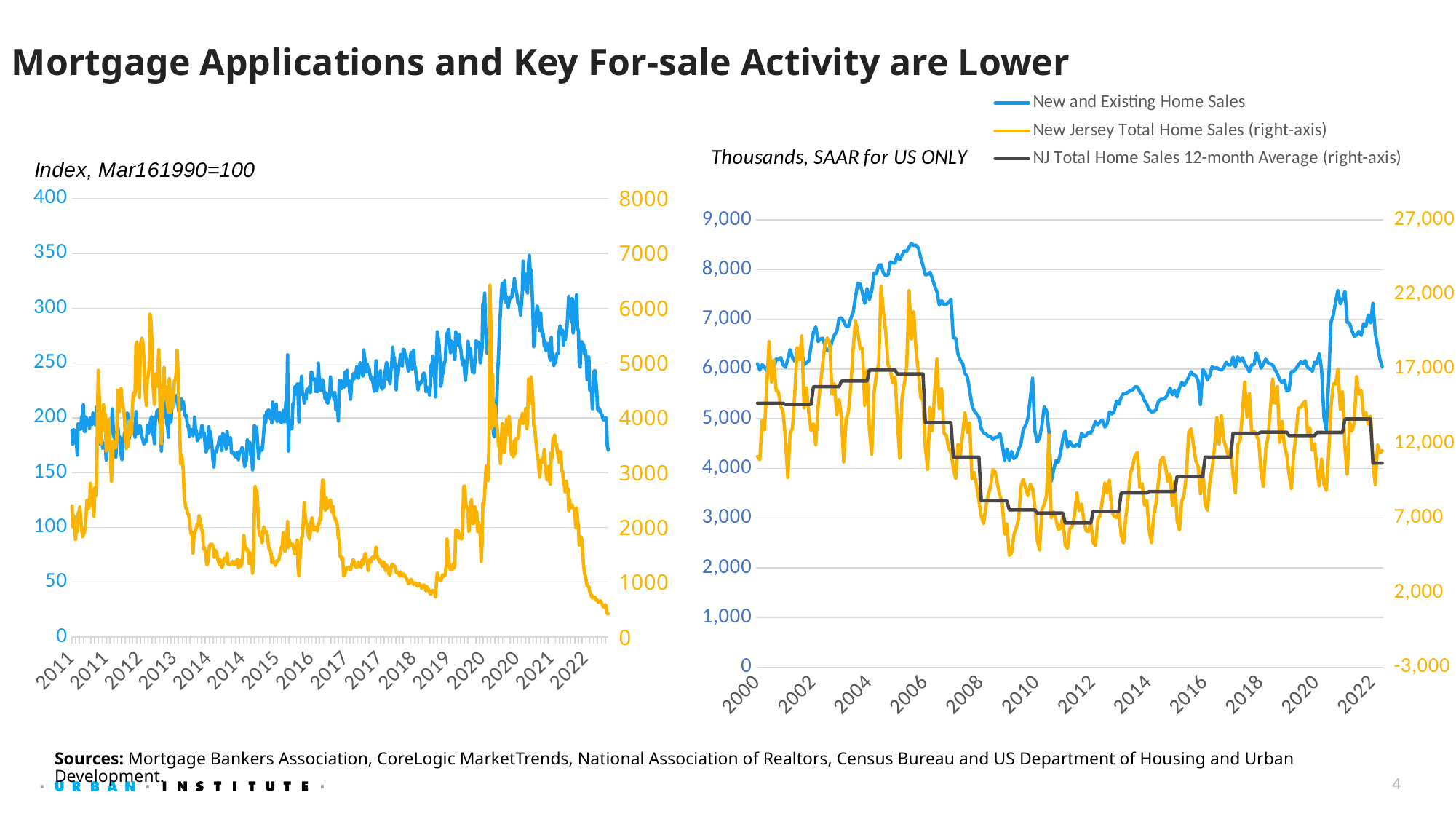
What kind of chart is the chart on the right titled "Thousands, SAAR for US ONLY"? line chart What kind of chart is the chart on the left titled "Index, Mar161990=100"? line chart In the right chart ("Thousands, SAAR for US ONLY"), does New and Existing Home Sales rise or fall between 2011 and 2019? rise In the right chart ("Thousands, SAAR for US ONLY"), does New and Existing Home Sales rise or fall between 2006 and 2009? fall In the right chart ("Thousands, SAAR for US ONLY"), how many series does the legend list? 3 In the right chart ("Thousands, SAAR for US ONLY"), which series is plotted against the right axis as a 12-month average? NJ Total Home Sales 12-month Average (right-axis) In the left chart ("Index, Mar161990=100"), is the orange line during 2018 greater or less than 2000 on the right axis? less In the right chart ("Thousands, SAAR for US ONLY"), is the peak value of New and Existing Home Sales around 2005 greater or less than 8,000? greater In the left chart ("Index, Mar161990=100"), is the peak of the blue line around 2020-2021 greater or less than 300 on the left axis? greater In the left chart ("Index, Mar161990=100"), how many lines are plotted? 2 In the left chart ("Index, Mar161990=100"), does the blue line rise or fall over the course of 2022? fall